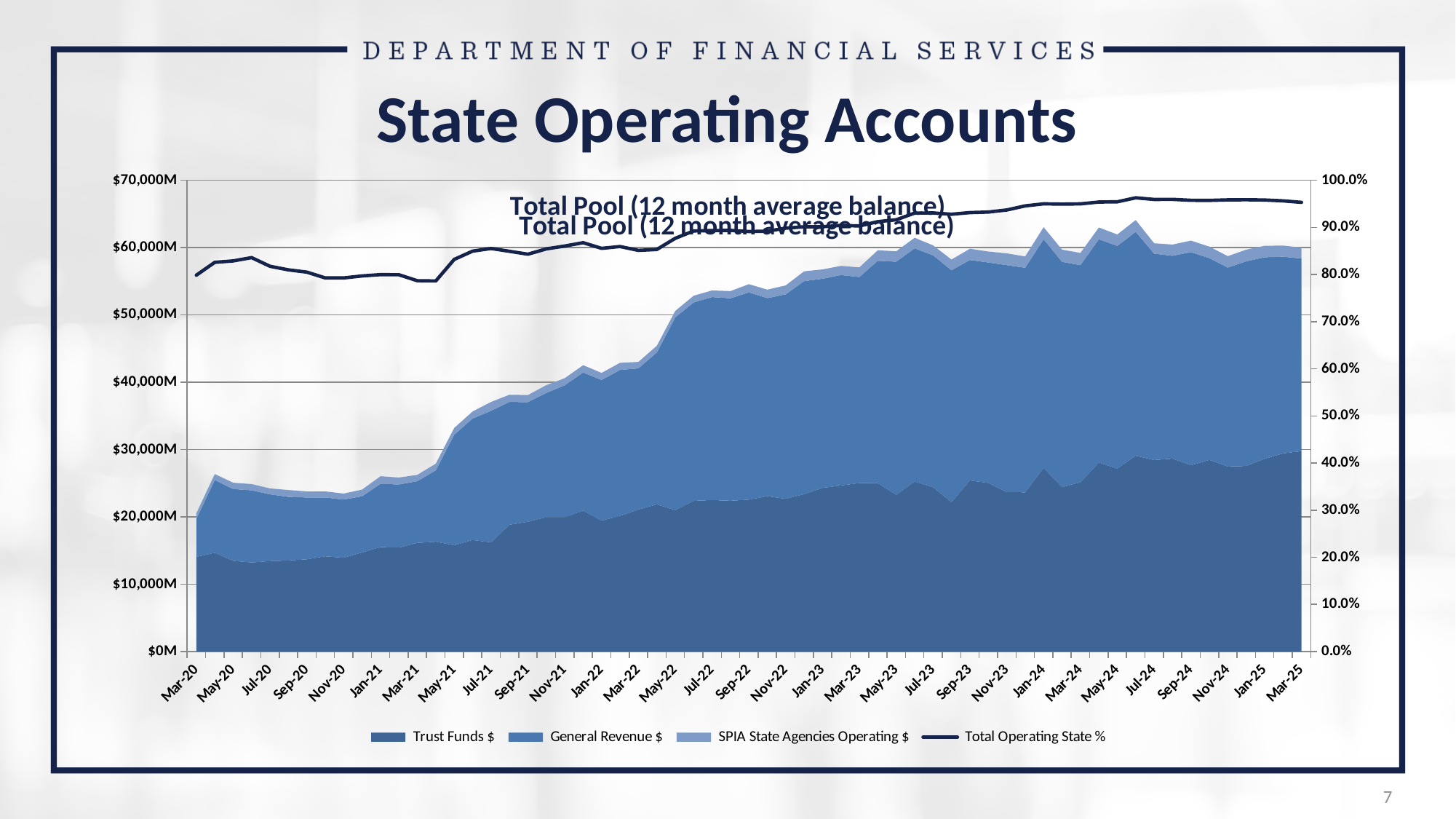
Which series is plotted as a line rather than a filled area? Total Operating State % How many series does the legend list? 4 Does the total stacked balance generally rise or fall from Mar-20 to Mar-25? rise Is the total stacked balance larger at Mar-20 or at Mar-25? Mar-25 Is the Total Operating State % at Mar-25 greater or less than 90.0%? greater Is the total stacked balance at Jul-21 greater or less than $30,000M? greater Is the Trust Funds $ value at Jan-24 greater or less than $30,000M? less What is the title printed inside the chart? Total Pool (12 month average balance) What kind of chart is shown on the slide? combination area and line chart Does the Total Operating State % line generally rise or fall from Mar-20 to Mar-25? rise